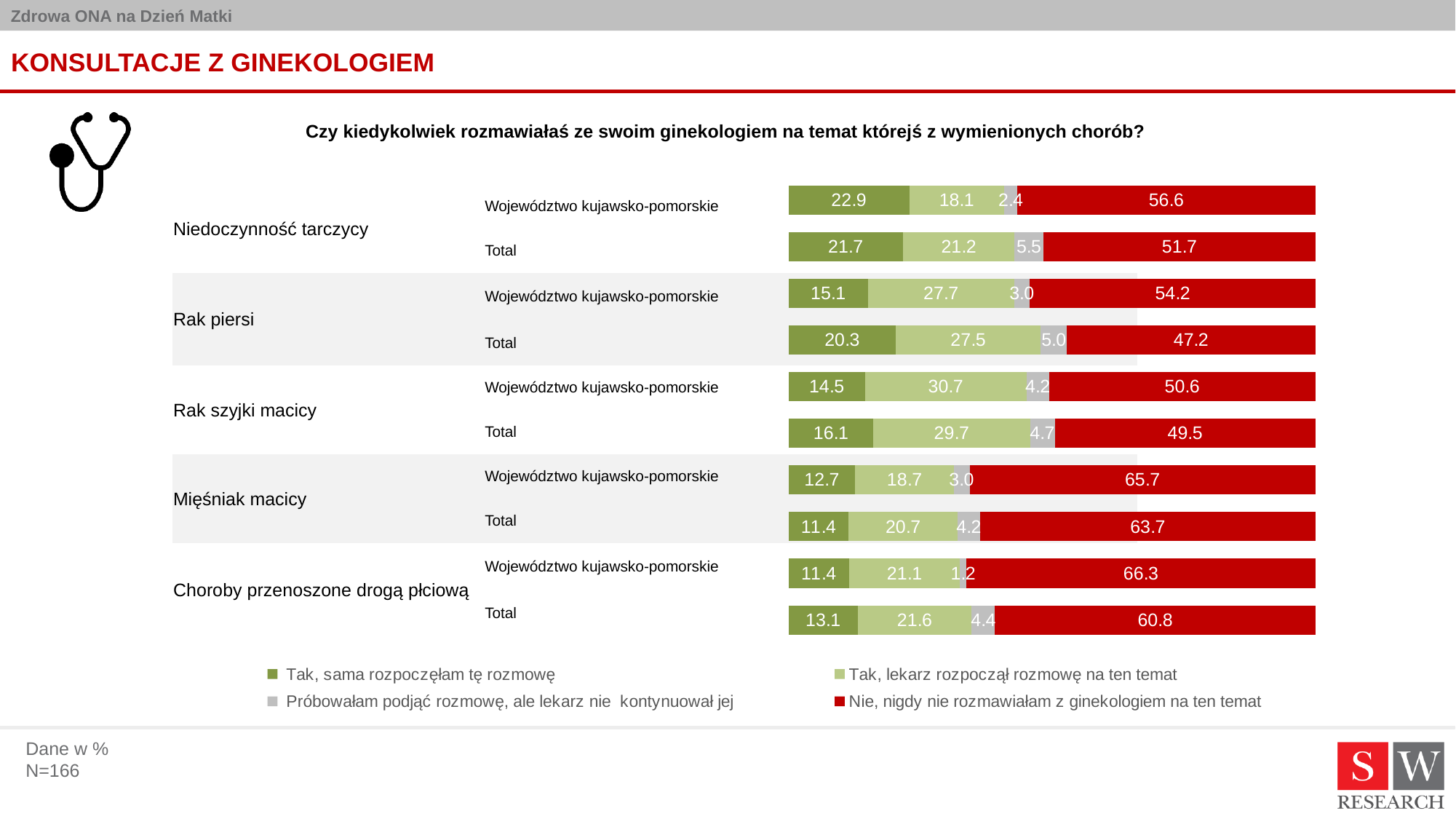
What is the Total value for "Próbowałam podjąć rozmowę, ale lekarz nie kontynuował jej" for Choroby przenoszone drogą płciową? 4.4 Which disease has the lowest Total value for "Nie, nigdy nie rozmawiałam z ginekologiem na ten temat"? Rak piersi How many series does the legend list? 4 What kind of chart is shown on the slide? Stacked bar chart For Mięśniak macicy, what is the difference between the Województwo kujawsko-pomorskie and Total values for "Nie, nigdy nie rozmawiałam z ginekologiem na ten temat"? 2.0 For Niedoczynność tarczycy, what is the difference between the Województwo kujawsko-pomorskie and Total values for "Nie, nigdy nie rozmawiałam z ginekologiem na ten temat"? 4.9 Which disease has the highest "Nie, nigdy nie rozmawiałam z ginekologiem na ten temat" value for Województwo kujawsko-pomorskie? Choroby przenoszone drogą płciową Which disease has the highest "Tak, sama rozpoczęłam tę rozmowę" value for Województwo kujawsko-pomorskie? Niedoczynność tarczycy For Rak szyjki macicy, which is larger for "Tak, lekarz rozpoczął rozmowę na ten temat": Województwo kujawsko-pomorskie or Total? Województwo kujawsko-pomorskie For Rak piersi, what is the Total value for "Tak, lekarz rozpoczął rozmowę na ten temat"? 27.5 What percentage of respondents from Województwo kujawsko-pomorskie answered "Nie, nigdy nie rozmawiałam z ginekologiem na ten temat" for Niedoczynność tarczycy? 56.6 How many diseases are shown in the chart? 5